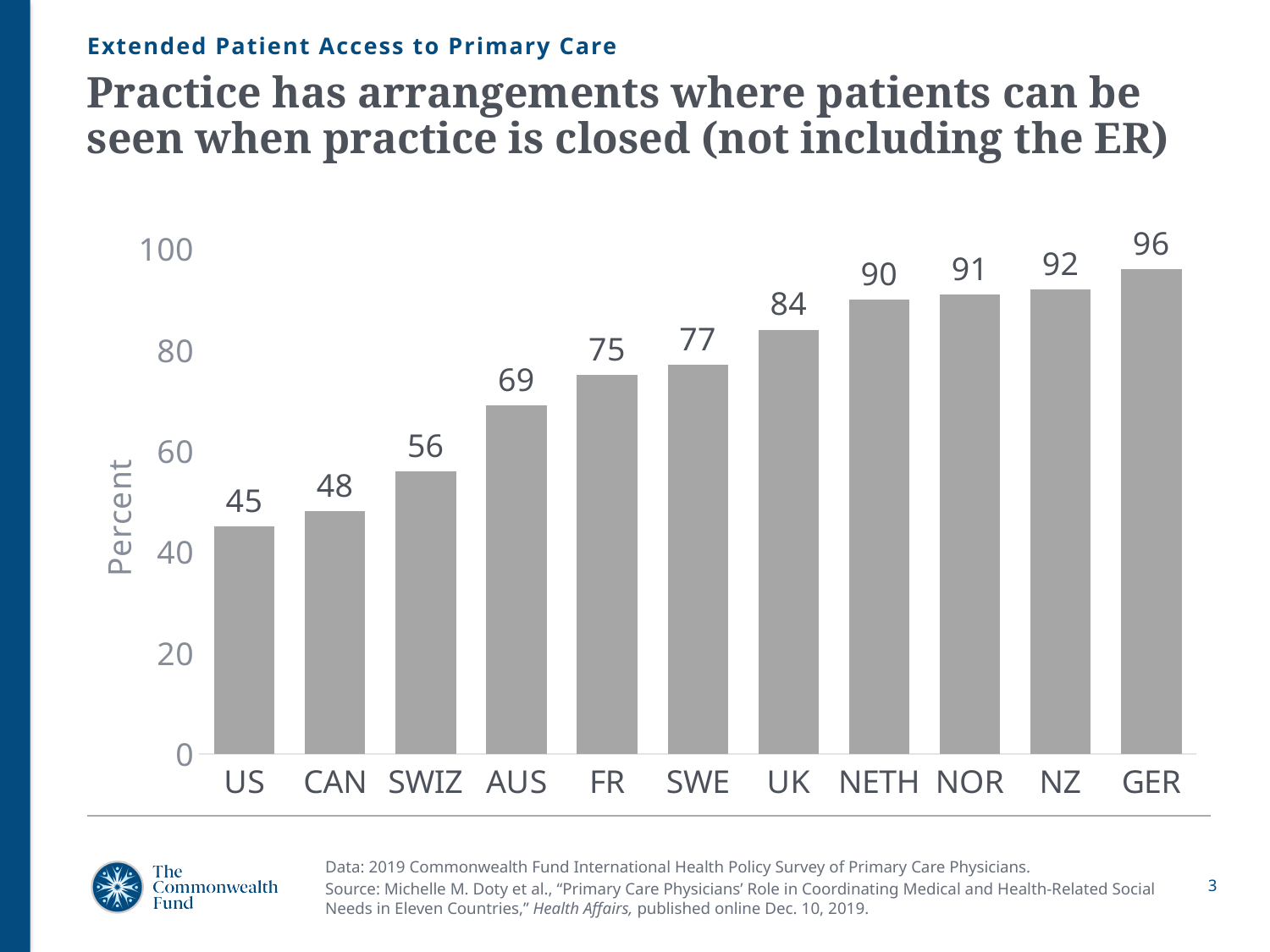
Which is larger, the value for CAN or the value for SWIZ? SWIZ Is the value for FR greater or less than 80? less Which country has the highest value? GER Which country has the lowest value? US What is the difference between the values for GER and US? 51 What is the difference between the values for UK and AUS? 15 What is the value for the US? 45 How many countries are shown on the chart? 11 What is the label on the vertical axis? Percent What is the value for SWE? 77 What kind of chart is shown on the slide? bar chart What is the value for NETH? 90